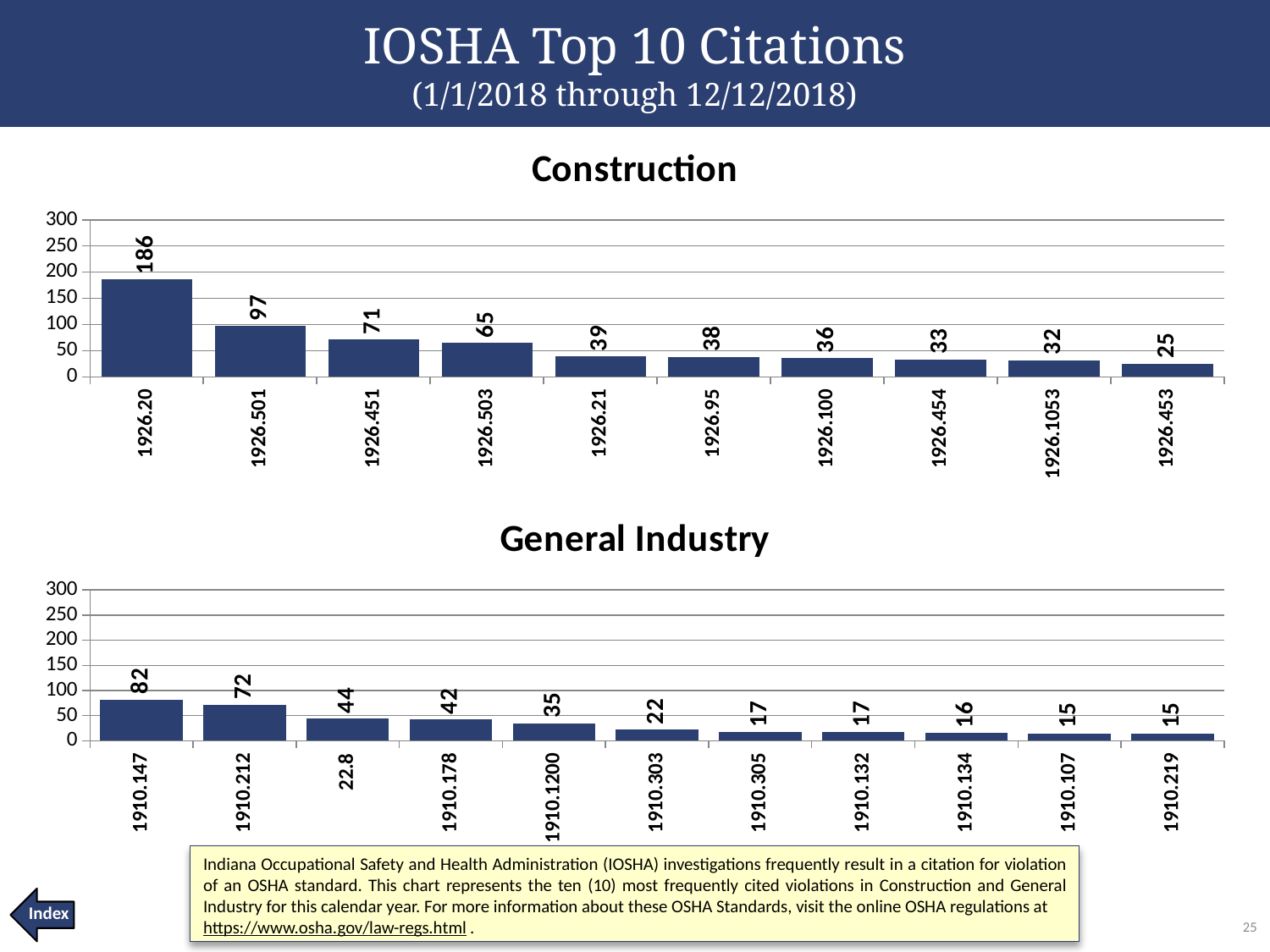
In the Construction chart, which category has the lowest value? 1926.453 In the Construction chart, which category has the highest value? 1926.20 In the General Industry chart, which category has the highest value? 1910.147 In the General Industry chart, what is the difference between the values for 1910.147 and 1910.212? 10 In the General Industry chart, which is larger, the value for 22.8 or the value for 1910.303? 22.8 In the Construction chart, how many categories are shown? 10 In the General Industry chart, what is the value for 1910.1200? 35 In the Construction chart, do the values rise or fall from left to right along the x axis? Fall In the Construction chart, what is the difference between the values for 1926.20 and 1926.501? 89 What kind of chart is the Construction chart? Bar chart In the General Industry chart, how many categories are shown? 11 In the Construction chart, what is the value for 1926.501? 97